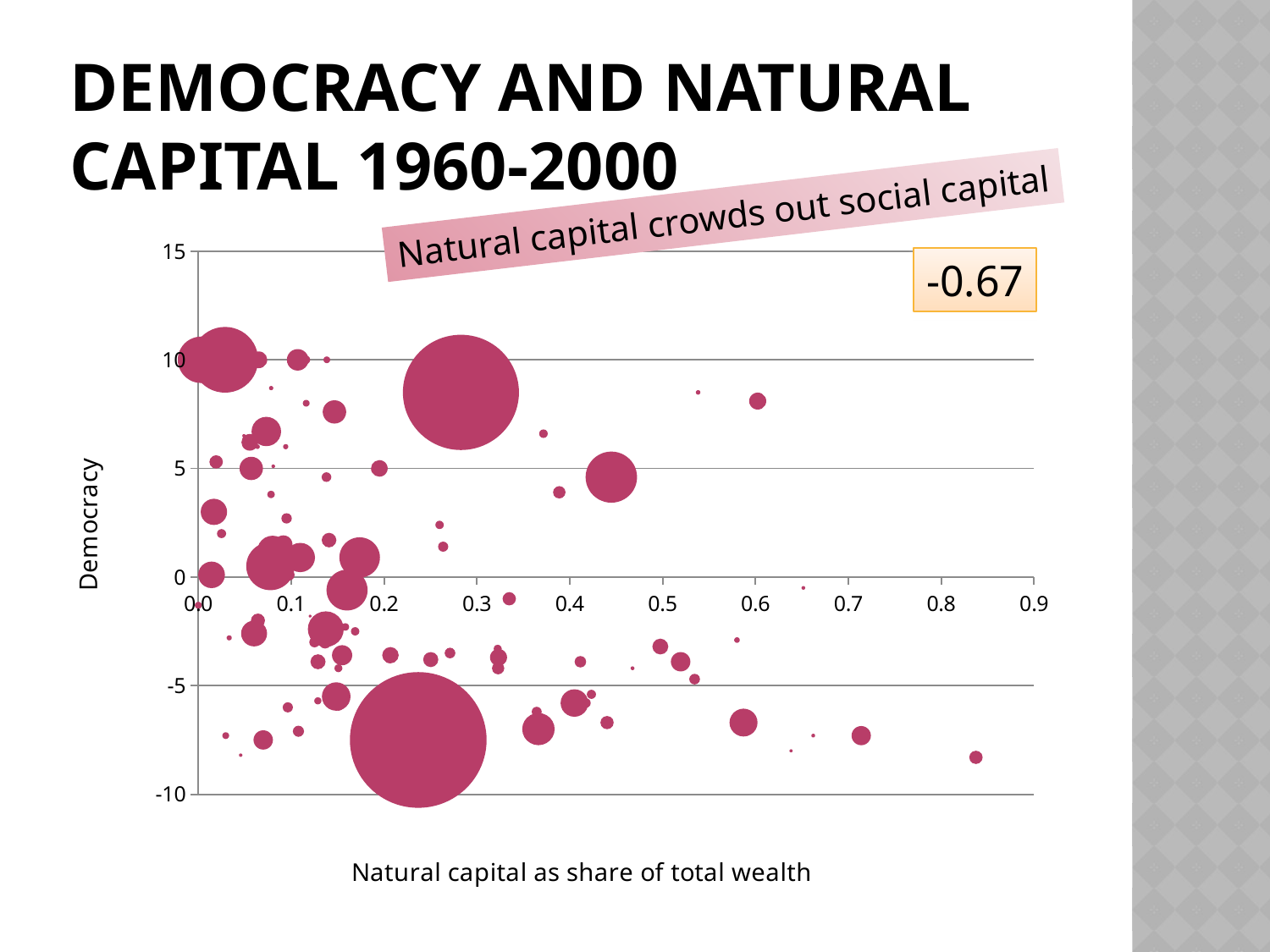
What number is shown in the highlighted box in the upper right of the chart? -0.67 What is the title of the x axis of the chart? Natural capital as share of total wealth Is the natural capital share for the rightmost bubble on the chart greater or less than 0.8? greater As natural capital as share of total wealth increases along the x axis, do the democracy values generally rise or fall? fall What kind of chart is shown on the slide? bubble chart Which has the higher democracy value: the largest bubble on the chart or the large bubble located near 0.3 on the x axis? the large bubble near 0.3 Is the natural capital share for the largest bubble on the chart greater or less than 0.5? less Is the democracy value for the largest bubble on the chart greater or less than -5? less